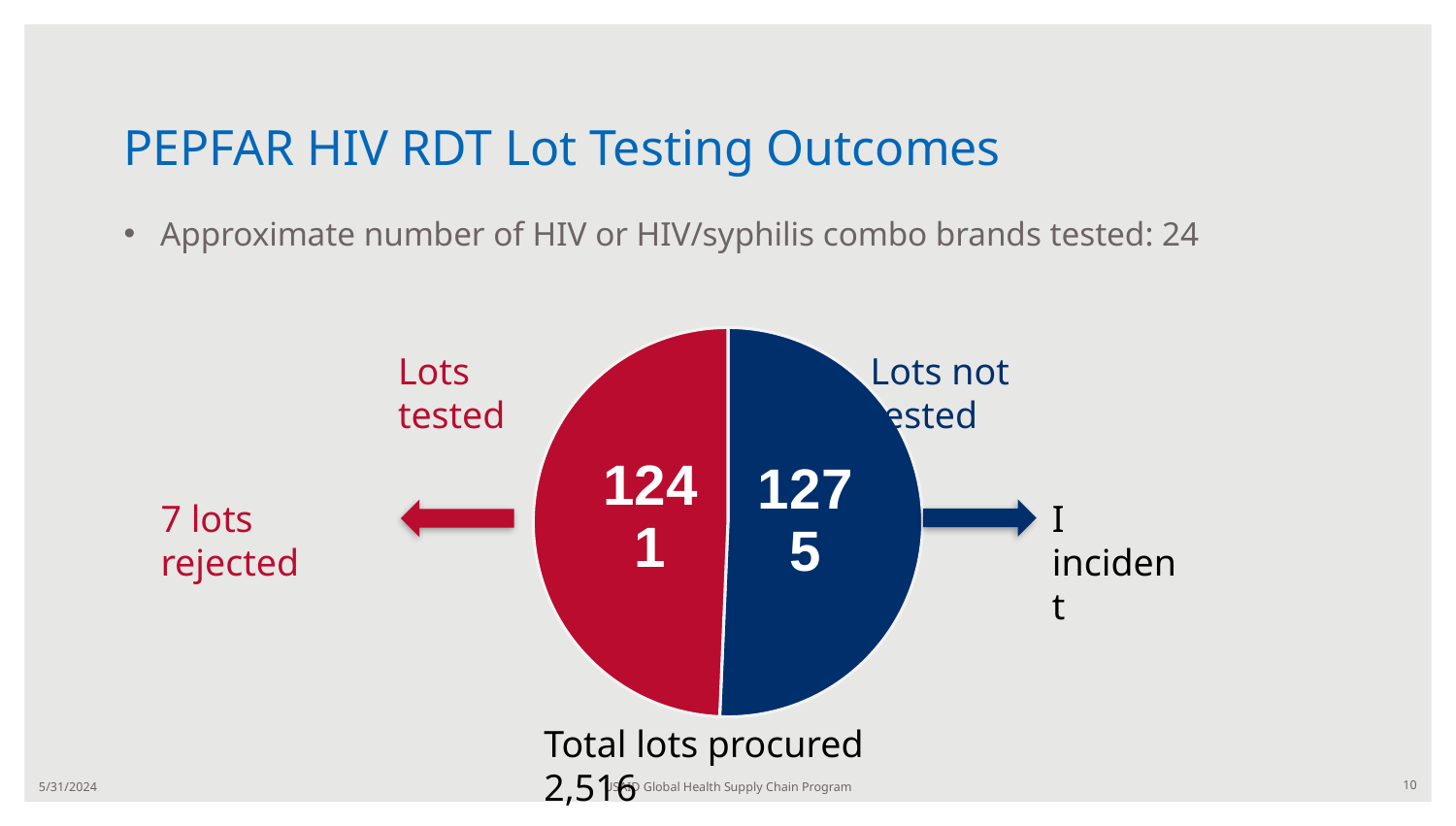
Is the number of lots tested greater or less than 1000? greater How many lots were tested according to the pie chart? 1241 What type of chart is shown on the slide? pie chart What is the difference between the number of lots not tested and the number of lots tested? 34 How many lots were not tested according to the pie chart? 1275 What is the total number of lots procured shown below the pie chart? 2,516 How many slices does the pie chart have? 2 Which slice of the pie chart is smaller, lots tested or lots not tested? Lots tested What colour is the 'Lots tested' slice of the pie chart? red Which slice of the pie chart is larger, lots tested or lots not tested? Lots not tested According to the slide, how many lots were rejected? 7 lots Is the number of lots not tested larger or smaller than the number of lots tested? larger